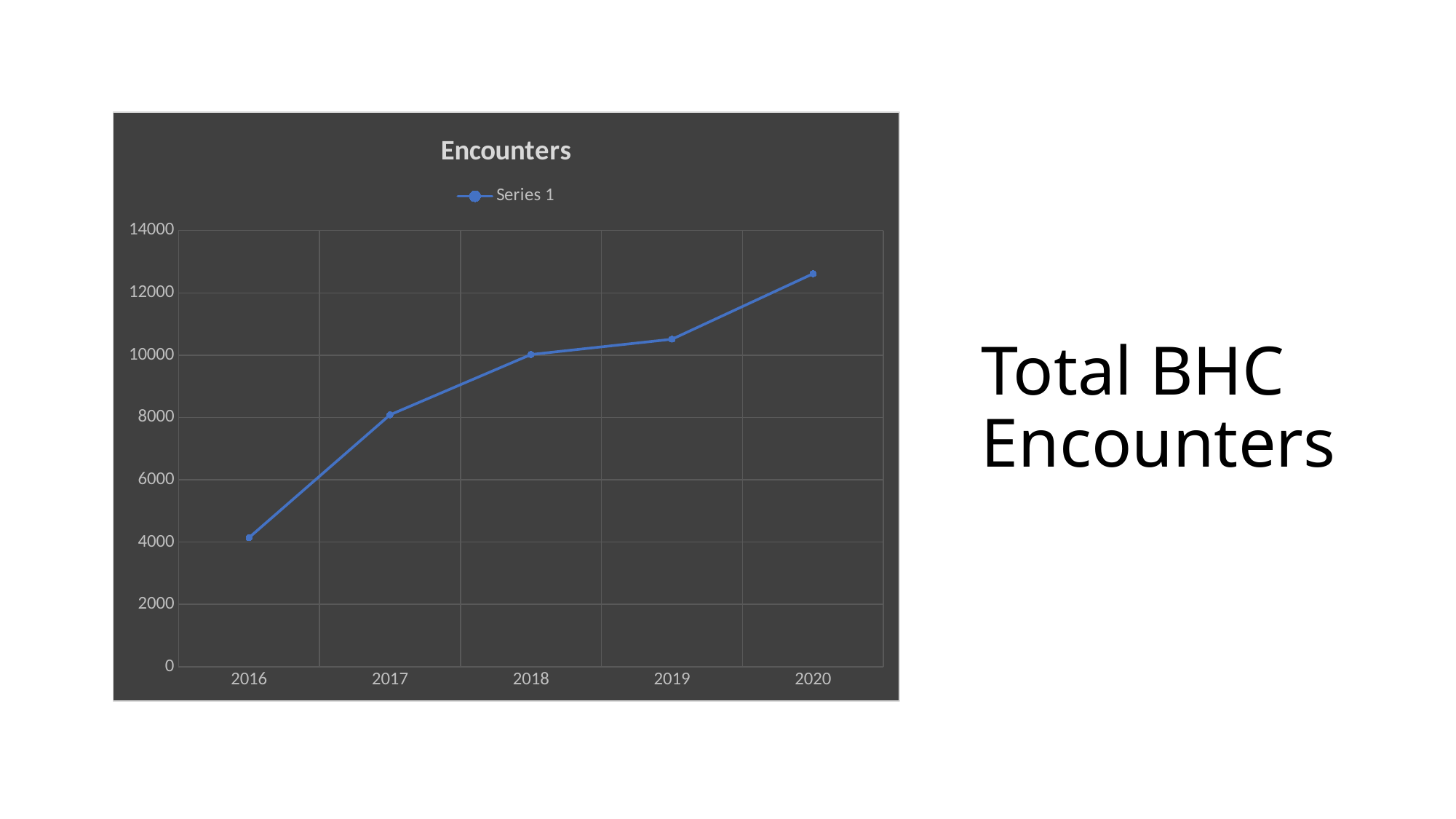
Which year has the lowest value? 2016 What is the name of the series shown in the legend? Series 1 Do the values rise or fall from 2016 to 2020? rise Which year has the highest value? 2020 How many years are plotted on the x axis? 5 Which is larger, the value for 2017 or the value for 2019? 2019 What kind of chart is shown on the slide? line chart Is the value for 2017 greater or less than 6000? greater How many series does the legend list? 1 Is the value for 2016 greater or less than 6000? less Is the value for 2020 greater or less than 12000? greater What is the title of the chart? Encounters